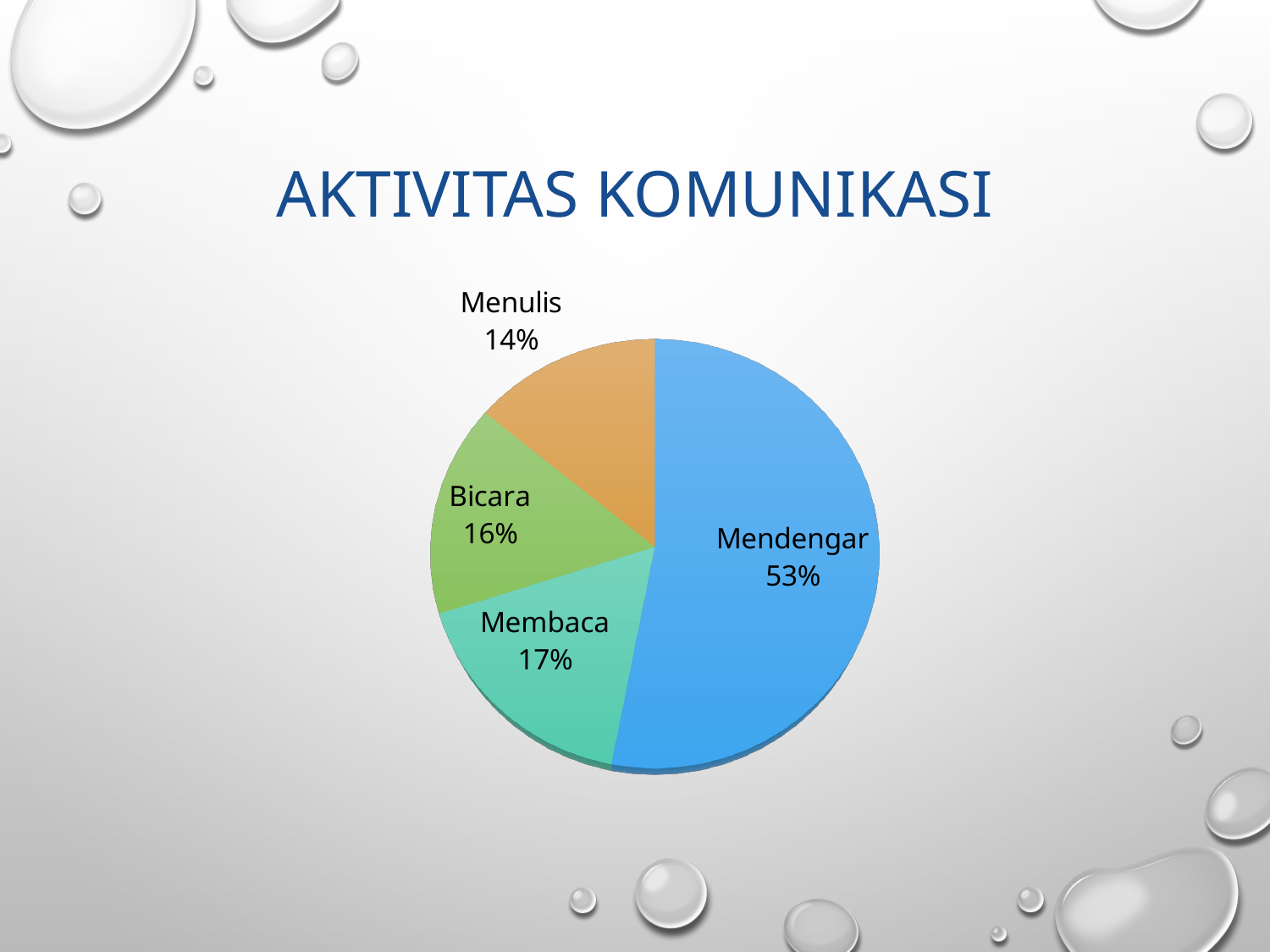
What share of the pie does Mendengar have? 53% What is the title of the slide containing the chart? AKTIVITAS KOMUNIKASI What is the difference between Bicara and Menulis? 2% What is the value for Menulis? 14% What is the value for Bicara? 16% What type of chart is shown on the slide? pie chart Which category has the smallest slice? Menulis How many categories are shown in the pie chart? 4 Which category has the largest slice? Mendengar Which is larger, Mendengar or Bicara? Mendengar What is the difference between Mendengar and Membaca? 36% What is the value for Membaca? 17%